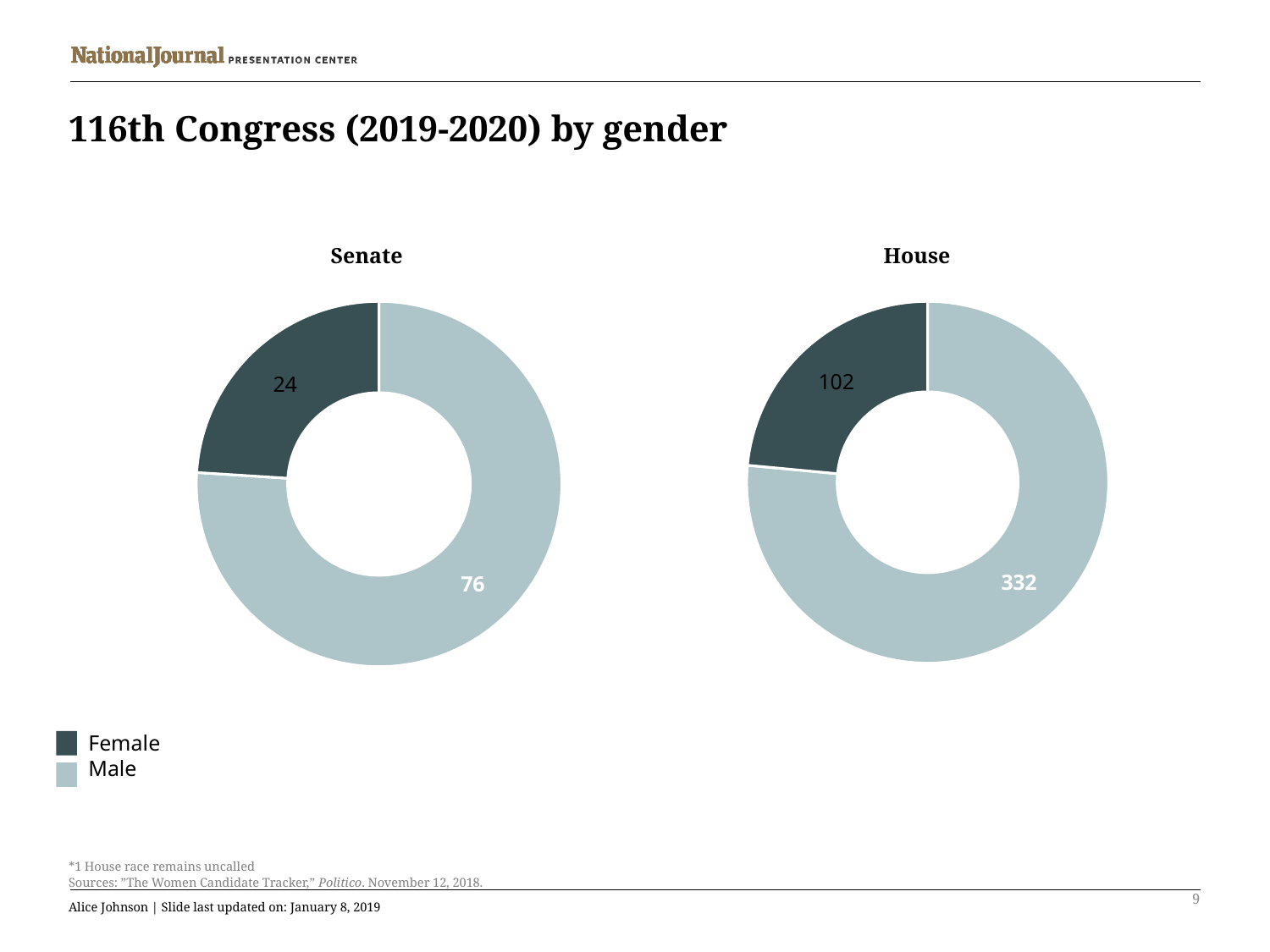
In the Senate chart, what is the difference between the Male and Female values? 52 Is the Female value larger in the Senate chart or the House chart? House In the House chart, how many members are Female? 102 In the House chart, which category has the largest slice? Male In the House chart, how many members are Male? 332 In the Senate chart, how many members are Male? 76 In the Senate chart, how many members are Female? 24 How many categories does the legend list? 2 In the House chart, what is the difference between the Male and Female values? 230 What type of chart is used for the Senate and House data? Doughnut chart In the Senate chart, what share of the total is Female? 24% In the Senate chart, which category has the smallest slice? Female